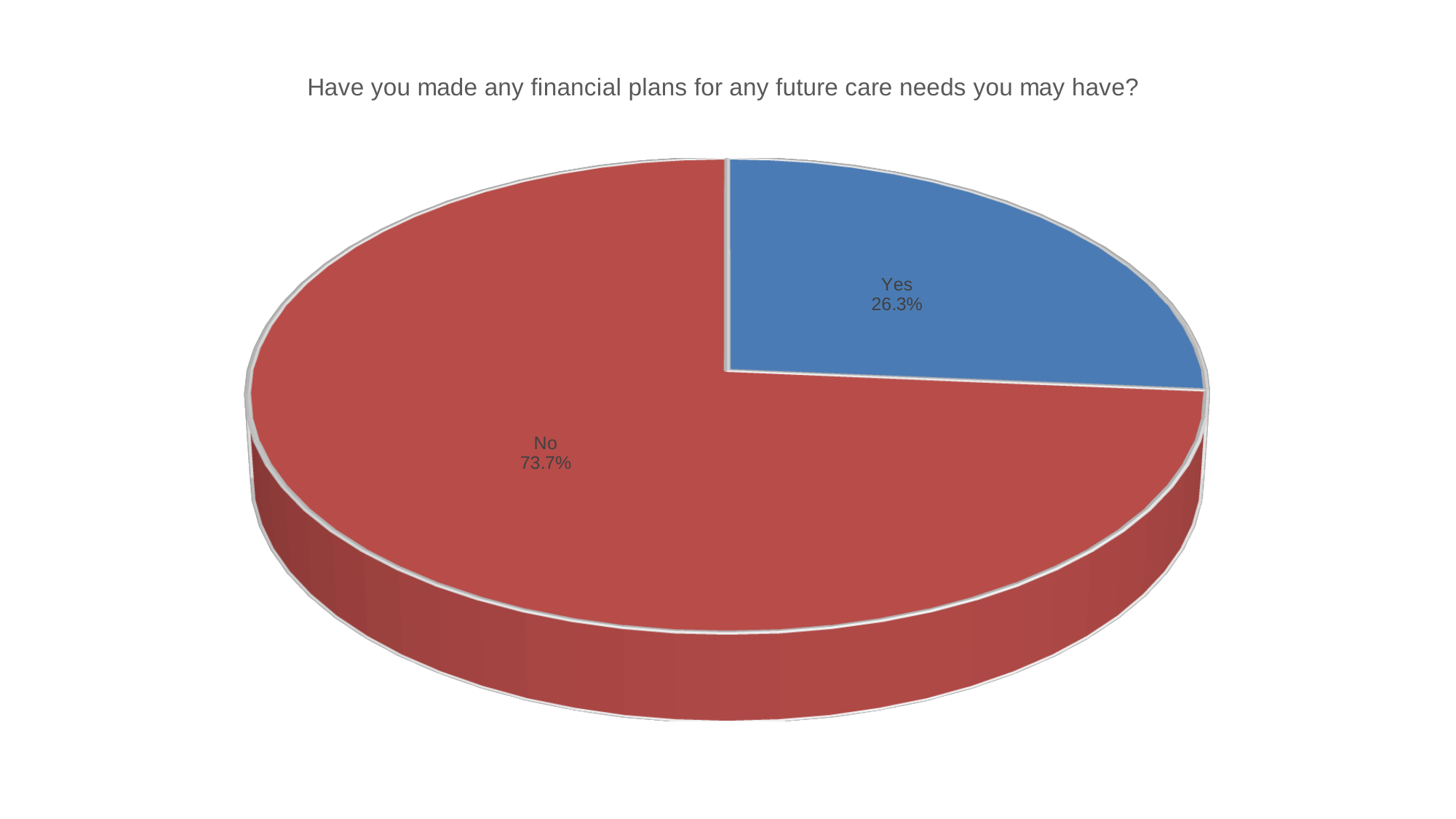
What percentage of respondents answered "No"? 73.7% Which slice is larger, "Yes" or "No"? No How many slices does the pie chart have? 2 What is the title of the chart? Have you made any financial plans for any future care needs you may have? What percentage of respondents answered "Yes"? 26.3% What is the difference in percentage points between the "No" and "Yes" slices? 47.4 What share of the pie does the "No" slice represent? 73.7% What colour is the "Yes" slice? Blue Which response has the largest share of the pie? No Which response has the smallest share of the pie? Yes What kind of chart is shown on the slide? Pie chart